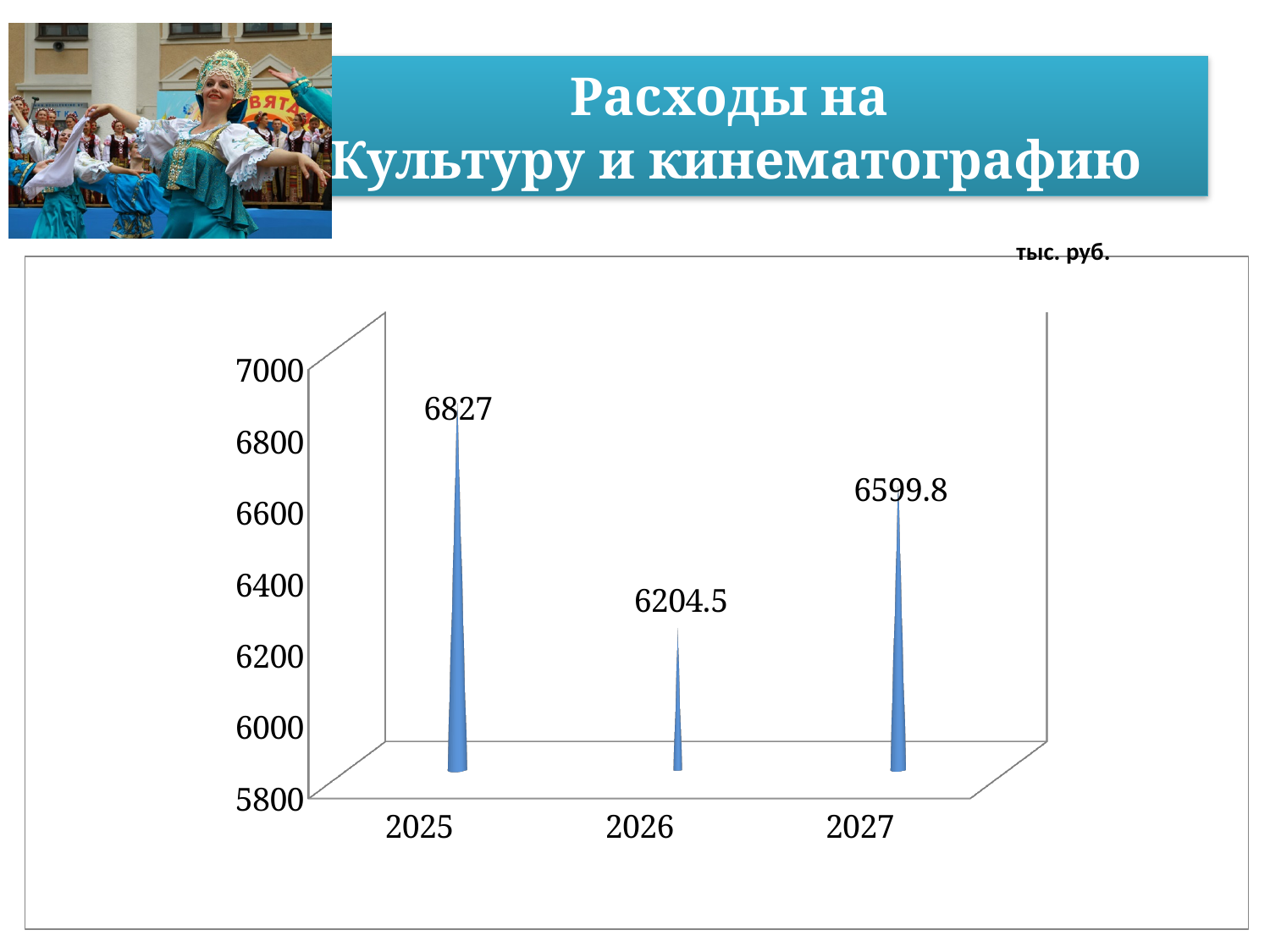
What is the value for 2026? 6204.5 Is the value for 2026 greater or less than 6400? less How many years are shown on the x axis? 3 What is the difference between the values for 2025 and 2026? 622.5 What kind of chart is shown on the slide? bar chart Which year has the highest value? 2025 What is the value for 2027? 6599.8 Which is larger, the value for 2025 or the value for 2027? 2025 What is the difference between the values for 2027 and 2026? 395.3 Which year has the lowest value? 2026 What is the value for 2025? 6827 What unit is indicated above the chart? тыс. руб.